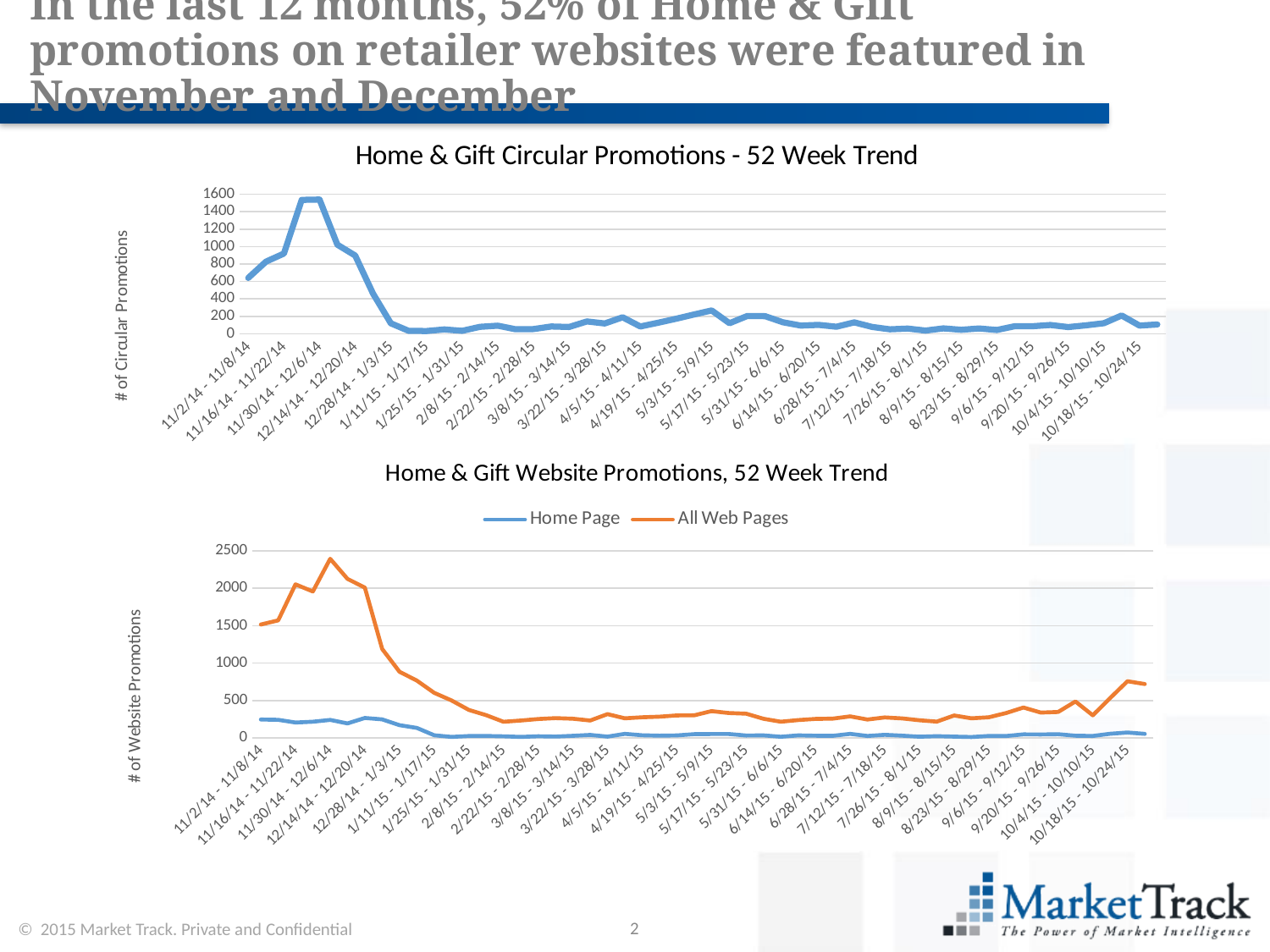
In the bottom chart, 'Home & Gift Website Promotions, 52 Week Trend', is the Home Page value for 11/2/14 - 11/8/14 greater or less than 500? less In the top chart, 'Home & Gift Circular Promotions - 52 Week Trend', is the value for 11/30/14 - 12/6/14 greater or less than 1400? greater What kind of chart is the top chart, 'Home & Gift Circular Promotions - 52 Week Trend'? Line chart In the bottom chart, 'Home & Gift Website Promotions, 52 Week Trend', which series has the larger value for 11/2/14 - 11/8/14, Home Page or All Web Pages? All Web Pages How many series does the legend of the bottom chart, 'Home & Gift Website Promotions, 52 Week Trend', list? 2 What kind of chart is the bottom chart, 'Home & Gift Website Promotions, 52 Week Trend'? Line chart In the bottom chart, 'Home & Gift Website Promotions, 52 Week Trend', is the All Web Pages value for 11/30/14 - 12/6/14 greater or less than 2000? greater In the bottom chart, 'Home & Gift Website Promotions, 52 Week Trend', does the All Web Pages line rise or fall from 11/30/14 - 12/6/14 to 1/25/15 - 1/31/15? fall In the bottom chart, 'Home & Gift Website Promotions, 52 Week Trend', which series is drawn in orange? All Web Pages In the bottom chart, 'Home & Gift Website Promotions, 52 Week Trend', which week has the highest All Web Pages value? 11/30/14 - 12/6/14 What is the y-axis label of the top chart, 'Home & Gift Circular Promotions - 52 Week Trend'? # of Circular Promotions